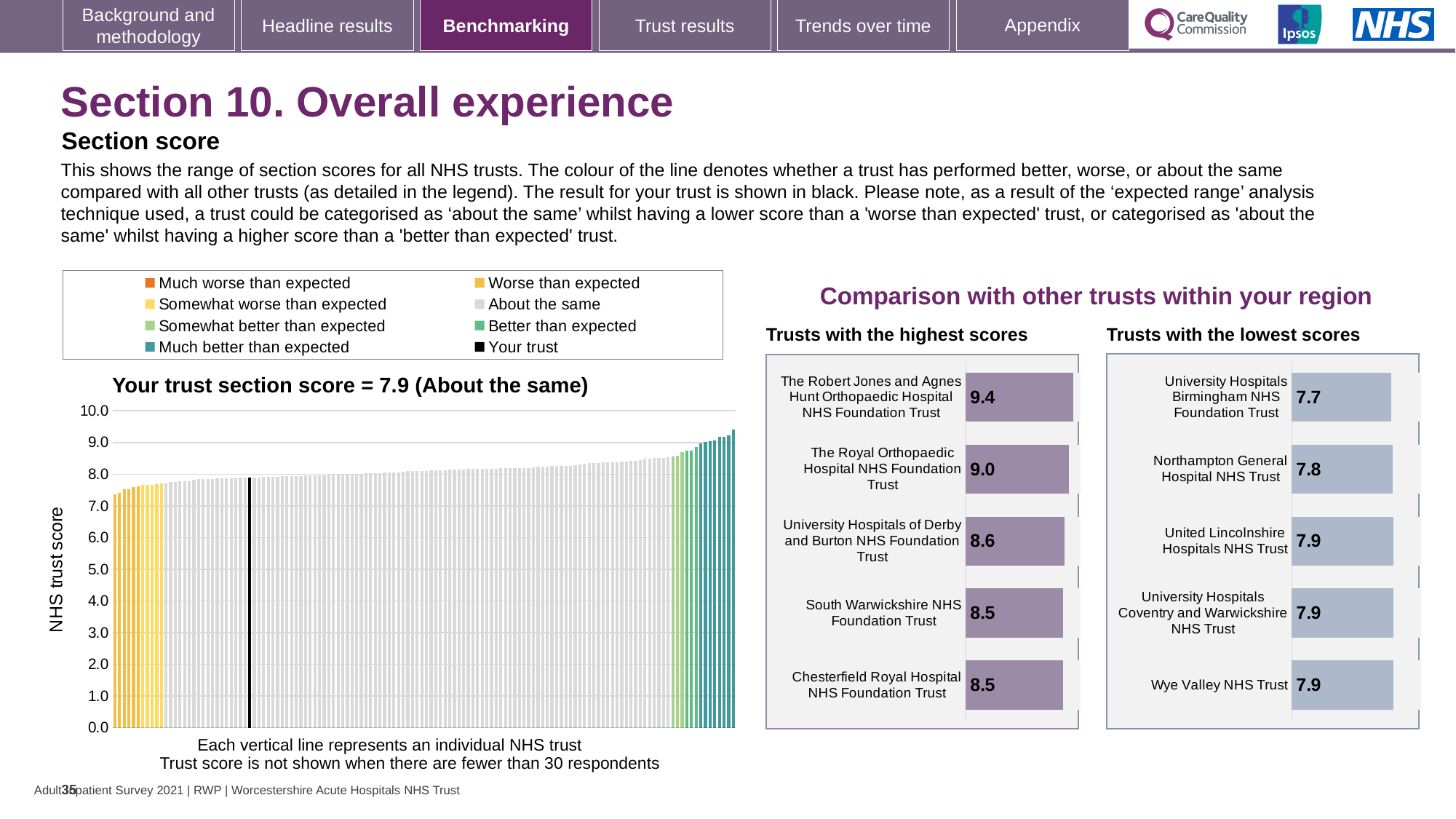
In the chart titled 'Your trust section score', what kind of chart is used to show the range of section scores? Bar chart In the 'Trusts with the highest scores' chart, which trust has the highest score? The Robert Jones and Agnes Hunt Orthopaedic Hospital NHS Foundation Trust In the 'Trusts with the lowest scores' chart, what is the score for Northampton General Hospital NHS Trust? 7.8 In the 'Trusts with the highest scores' chart, what is the difference between the scores of The Robert Jones and Agnes Hunt Orthopaedic Hospital NHS Foundation Trust and University Hospitals of Derby and Burton NHS Foundation Trust? 0.8 In the 'Trusts with the lowest scores' chart, which trust has the lowest score? University Hospitals Birmingham NHS Foundation Trust In the chart titled 'Your trust section score', what is the section score for your trust? 7.9 In the chart titled 'Your trust section score', do the trust scores rise or fall from left to right along the x axis? Rise How many entries does the legend above the 'Your trust section score' chart list? 8 In the chart titled 'Your trust section score', is the value of the tallest bar greater or less than 9.0? greater How many trusts are shown in the 'Trusts with the lowest scores' chart? 5 What is the y-axis label of the chart titled 'Your trust section score'? NHS trust score In the 'Trusts with the highest scores' chart, what is the score for The Royal Orthopaedic Hospital NHS Foundation Trust? 9.0